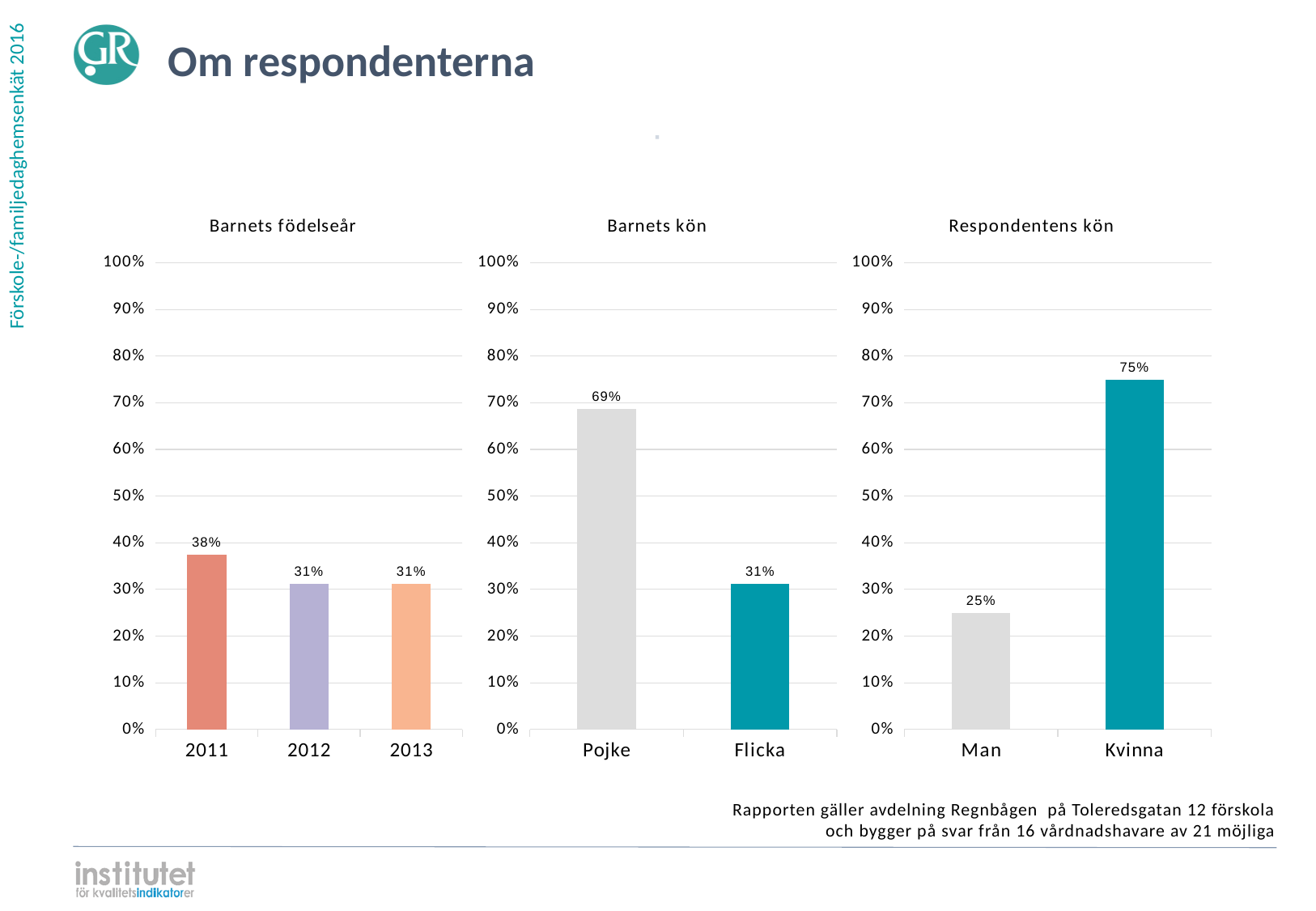
In the 'Barnets kön' chart, which category has the lowest value? Flicka In the 'Barnets födelseår' chart, how many categories are shown on the x axis? 3 In the 'Barnets kön' chart, what is the value for Pojke? 69% In the 'Barnets kön' chart, what is the difference between the values for Pojke and Flicka? 38% In the 'Barnets födelseår' chart, what is the difference between the values for 2011 and 2012? 7% In the 'Respondentens kön' chart, is the value for Man greater or less than 30%? less In the 'Respondentens kön' chart, which is larger, the value for Man or the value for Kvinna? Kvinna In the 'Barnets födelseår' chart, what is the value for 2011? 38% In the 'Respondentens kön' chart, what is the value for Kvinna? 75% In the 'Barnets födelseår' chart, which birth year has the highest value? 2011 What kind of chart is the 'Respondentens kön' chart? bar chart What is the title of the middle chart on the slide? Barnets kön